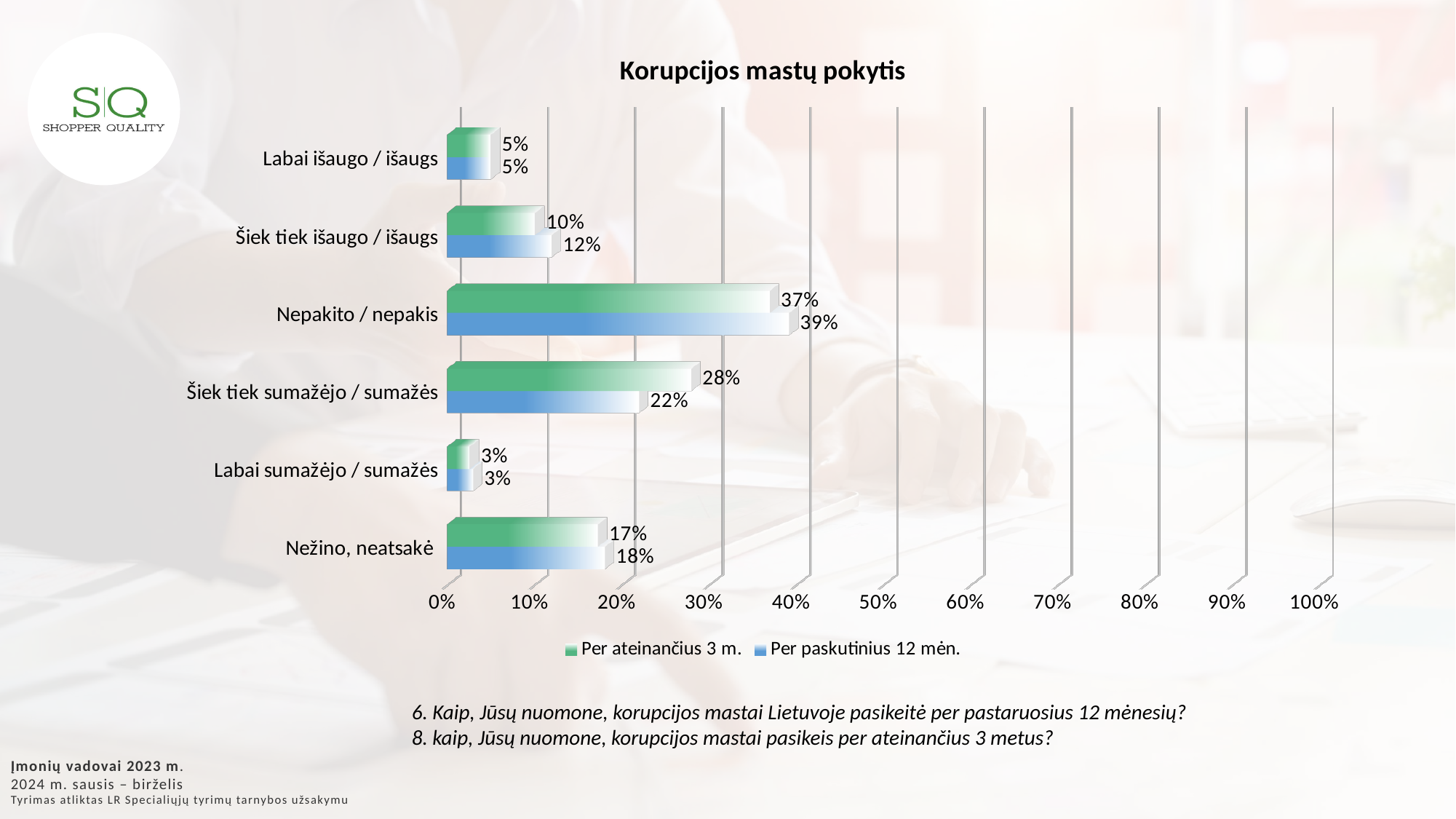
Which category has the highest value in the "Per ateinančius 3 m." series? Nepakito / nepakis For "Šiek tiek išaugo / išaugs", which series has the larger value? Per paskutinius 12 mėn. What is the value for "Šiek tiek sumažėjo / sumažės" in the "Per ateinančius 3 m." series? 28% What kind of chart is shown on the slide? Bar chart What is the title of the chart? Korupcijos mastų pokytis What is the value for "Nepakito / nepakis" in the "Per paskutinius 12 mėn." series? 39% How many categories are shown on the chart? 6 What is the value for "Nežino, neatsakė" in the "Per paskutinius 12 mėn." series? 18% Which category has the lowest value in the "Per paskutinius 12 mėn." series? Labai sumažėjo / sumažės Is the "Per paskutinius 12 mėn." value for "Nepakito / nepakis" greater or less than 30%? greater What is the difference between the "Per ateinančius 3 m." and "Per paskutinius 12 mėn." values for "Šiek tiek sumažėjo / sumažės"? 6% How many series does the legend list? 2